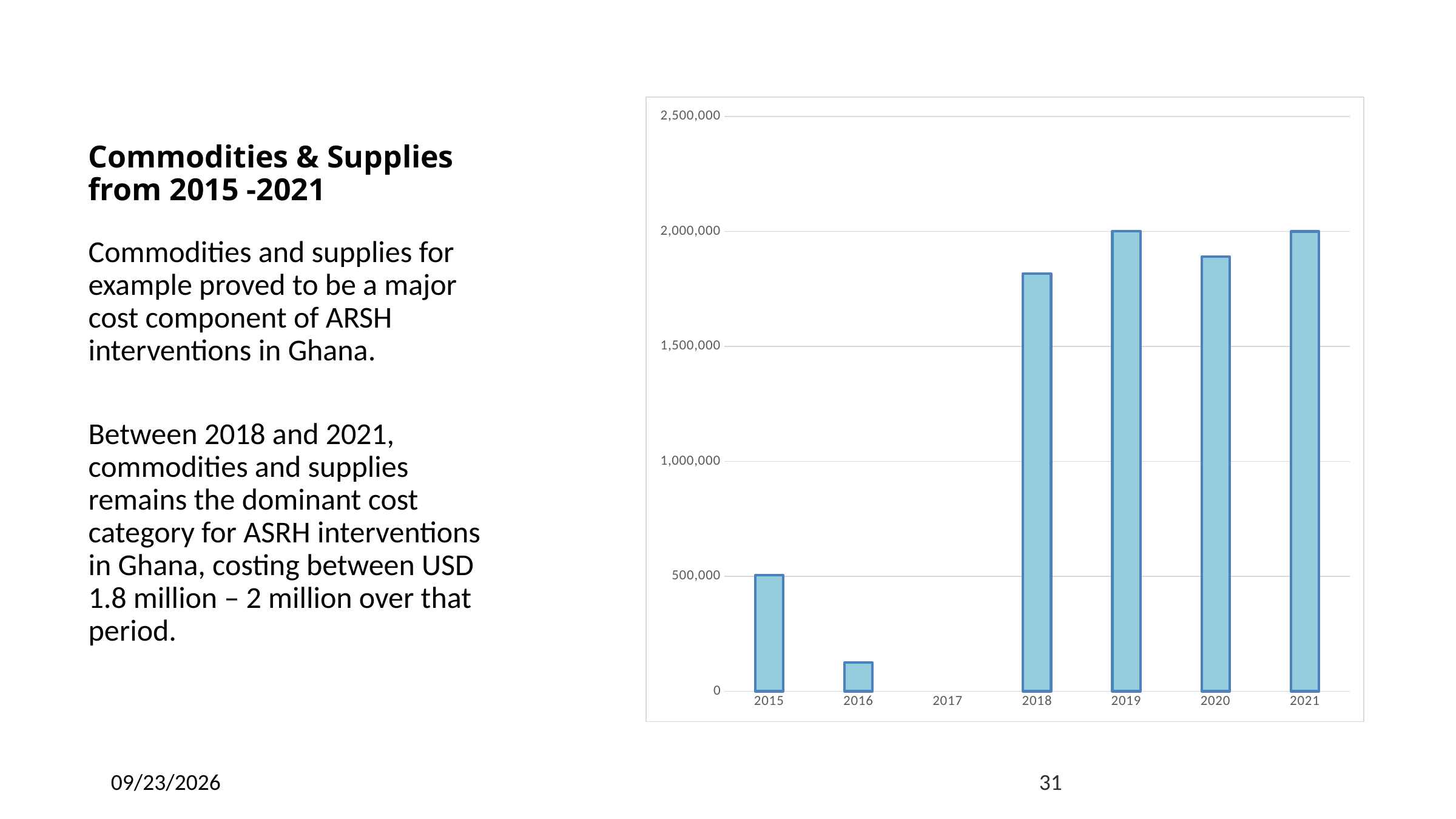
What kind of chart is shown on the slide? bar chart What is the highest value shown on the y axis of the chart? 2,500,000 From 2015 to 2016, does the value rise or fall? fall Is the value for 2020 greater or less than 1,500,000? greater Is the value for 2016 greater or less than 500,000? less How many years are shown on the x axis of the chart? 7 Which year has the larger value, 2016 or 2021? 2021 Which year has the larger value, 2015 or 2018? 2018 Which year has the larger value, 2015 or 2016? 2015 Is the value for 2015 greater or less than 1,000,000? less